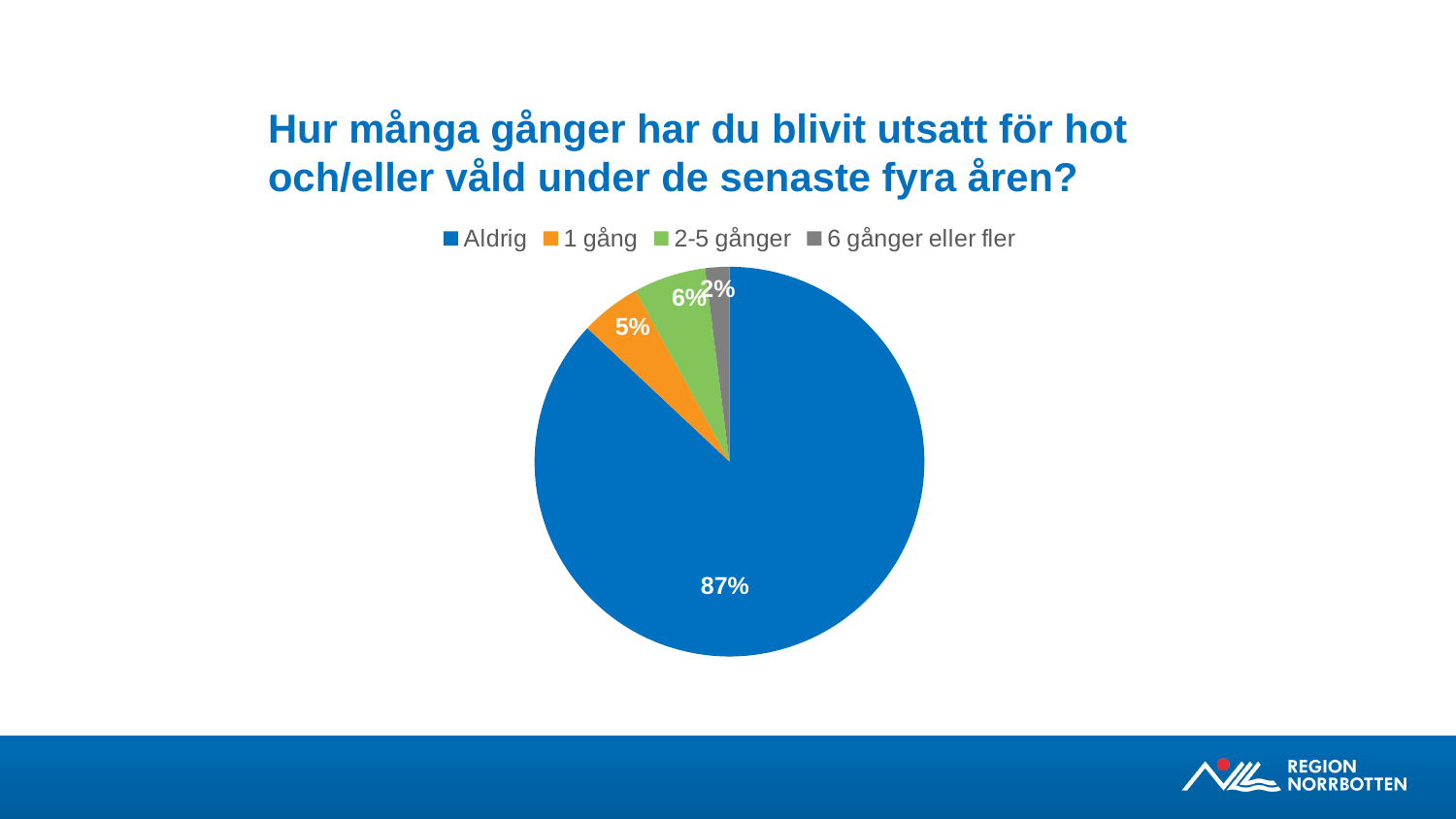
Which is larger, the value for "2-5 gånger" or the value for "1 gång"? 2-5 gånger What is the value shown for "1 gång"? 5% What share of the pie does "Aldrig" represent? 87% What colour is the slice for "1 gång"? orange How many categories does the legend list? 4 What kind of chart is shown on the slide? pie chart What is the difference between the values for "Aldrig" and "1 gång"? 82% What is the difference between the values for "2-5 gånger" and "6 gånger eller fler"? 4% What is the value shown for "2-5 gånger"? 6% What is the value shown for "6 gånger eller fler"? 2% Which category has the smallest slice of the pie? 6 gånger eller fler Which category has the largest slice of the pie? Aldrig